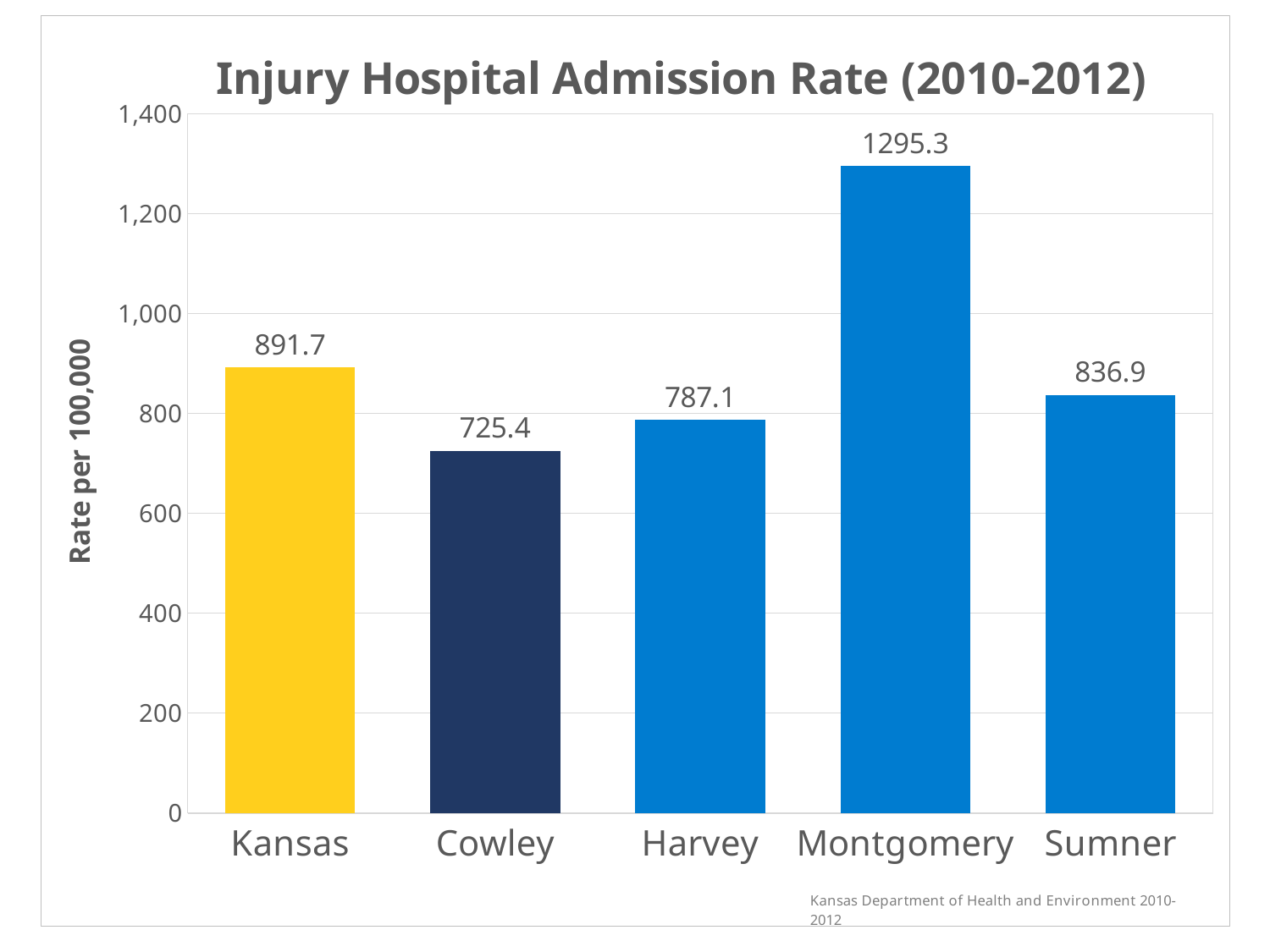
Is the value for Cowley greater or less than 800? less How many categories are shown on the x axis? 5 What is the injury hospital admission rate for Cowley? 725.4 What is the difference between the rates for Sumner and Harvey? 49.8 What is the difference between the rates for Montgomery and Kansas? 403.6 What kind of chart is shown on the slide? bar chart Which has a higher injury hospital admission rate, Harvey or Sumner? Sumner What is the injury hospital admission rate for Kansas? 891.7 Which category has the lowest injury hospital admission rate? Cowley What is the label of the y axis? Rate per 100,000 Which category has the highest injury hospital admission rate? Montgomery What is the injury hospital admission rate for Montgomery? 1295.3